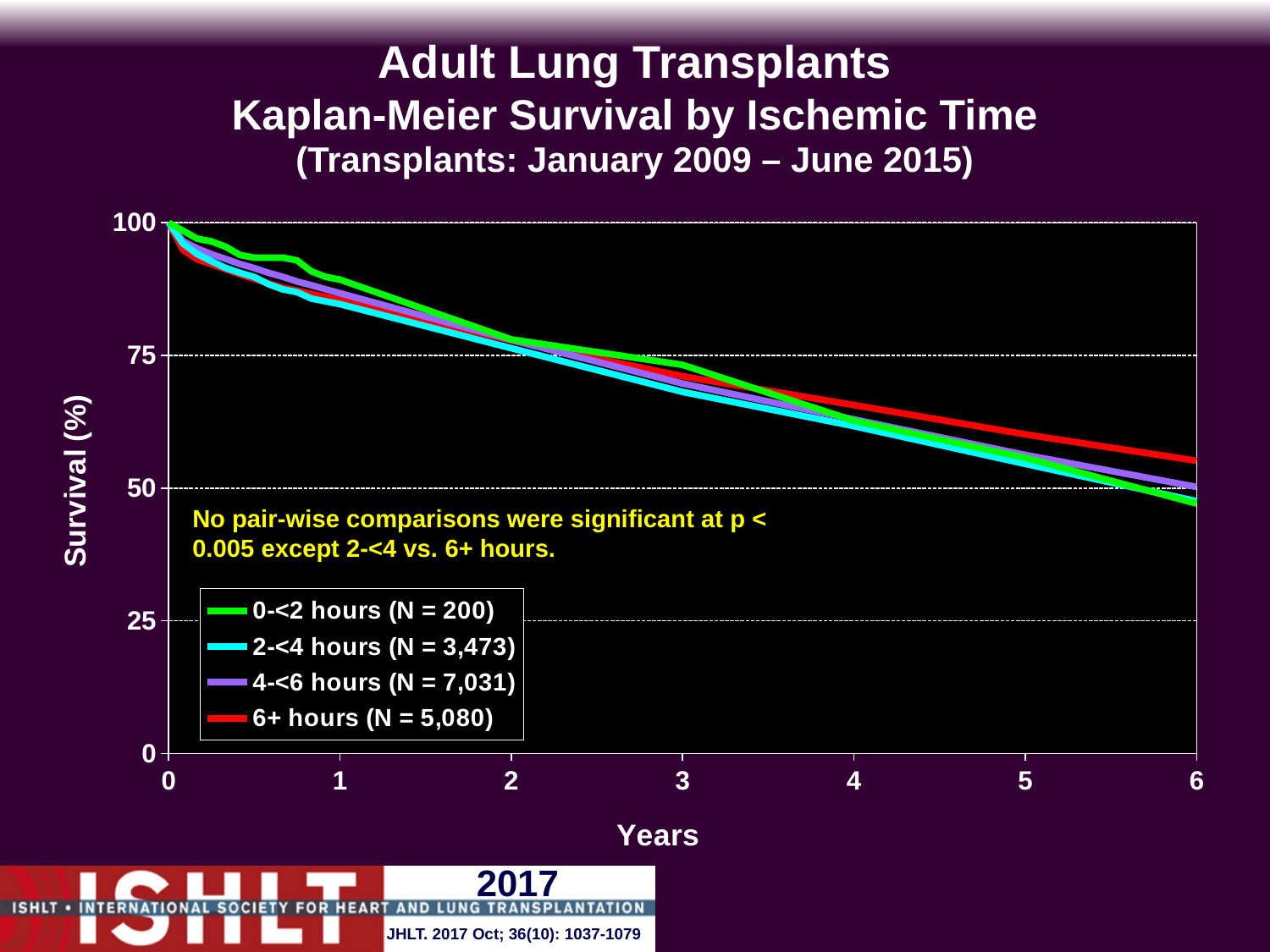
Which ischemic time group has the highest survival at 6 years? 6+ hours At 6 years, is survival for the 6+ hours group greater or less than 50? greater Do the survival curves rise or fall as years increase? fall How many series does the legend list? 4 What is the label of the x axis? Years What kind of chart is shown on the slide? line chart At 6 years, which has higher survival: the 6+ hours group or the 0-<2 hours group? 6+ hours At 6 years, is survival for the 0-<2 hours group greater or less than 50? less What is the N for the 4-<6 hours group in the legend? 7,031 What is the survival percentage for all groups at year 0? 100 At 5 years, is survival for the 2-<4 hours group greater or less than 50? greater